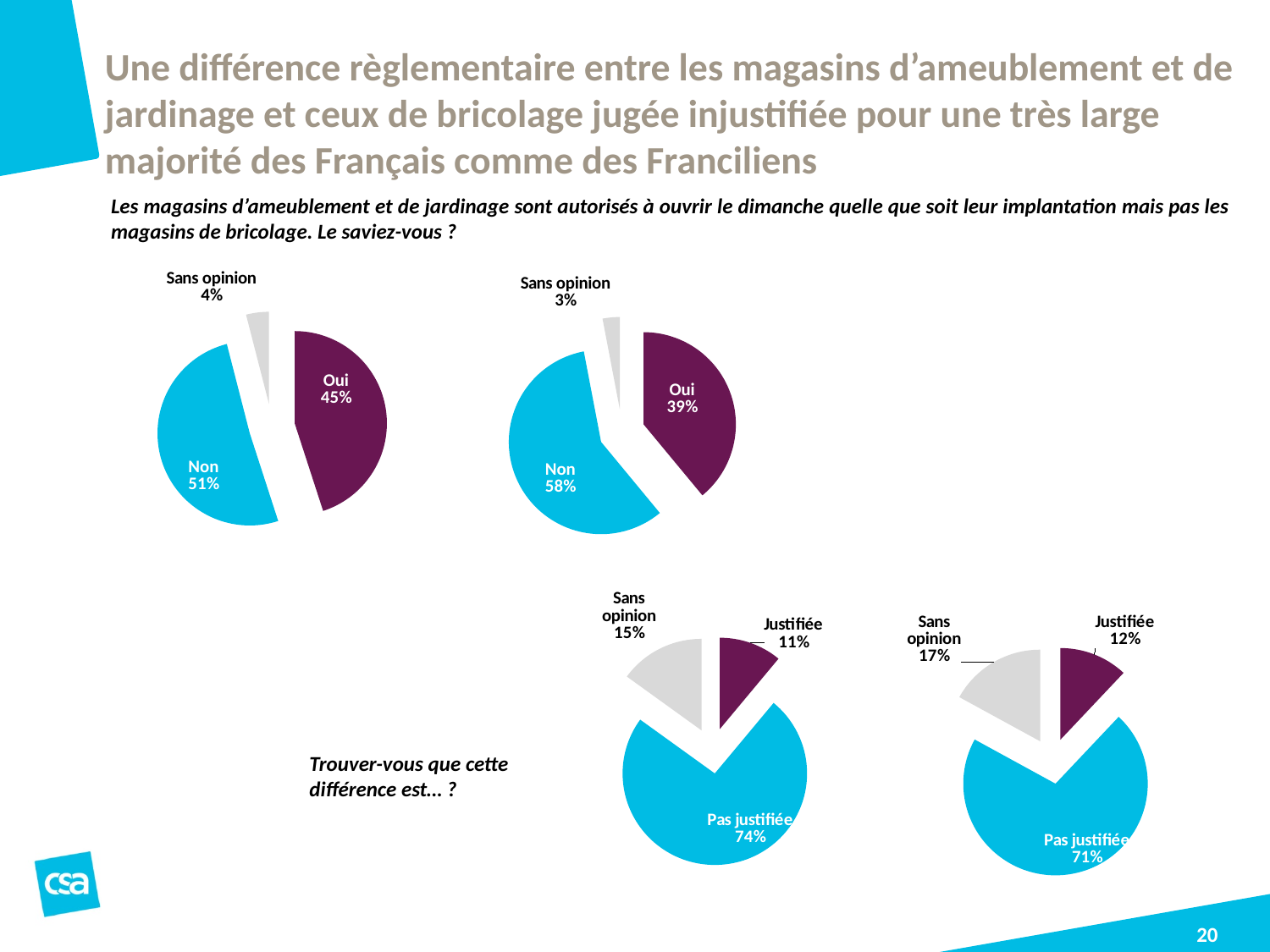
What type of chart is the bottom-right chart? Pie chart How many slices does the top-left pie chart have? 3 How many pie charts are shown on the slide? 4 In the bottom-right pie chart, which category has the smallest share? Justifiée In the top-right pie chart, what is the value for "Non"? 58% In the bottom-right pie chart, what is the value for "Pas justifiée"? 71% In the bottom-middle pie chart (the left of the two bottom charts), which is larger, "Sans opinion" or "Justifiée"? Sans opinion In the top-left pie chart, what colour is the "Oui" slice? Purple In the top-left pie chart, which category has the largest share? Non In the top-right pie chart, what is the difference between "Non" and "Oui"? 19 percentage points In the top-left pie chart, what is the value for "Oui"? 45% In the bottom-middle pie chart (the left of the two bottom charts), what is the value for "Sans opinion"? 15%